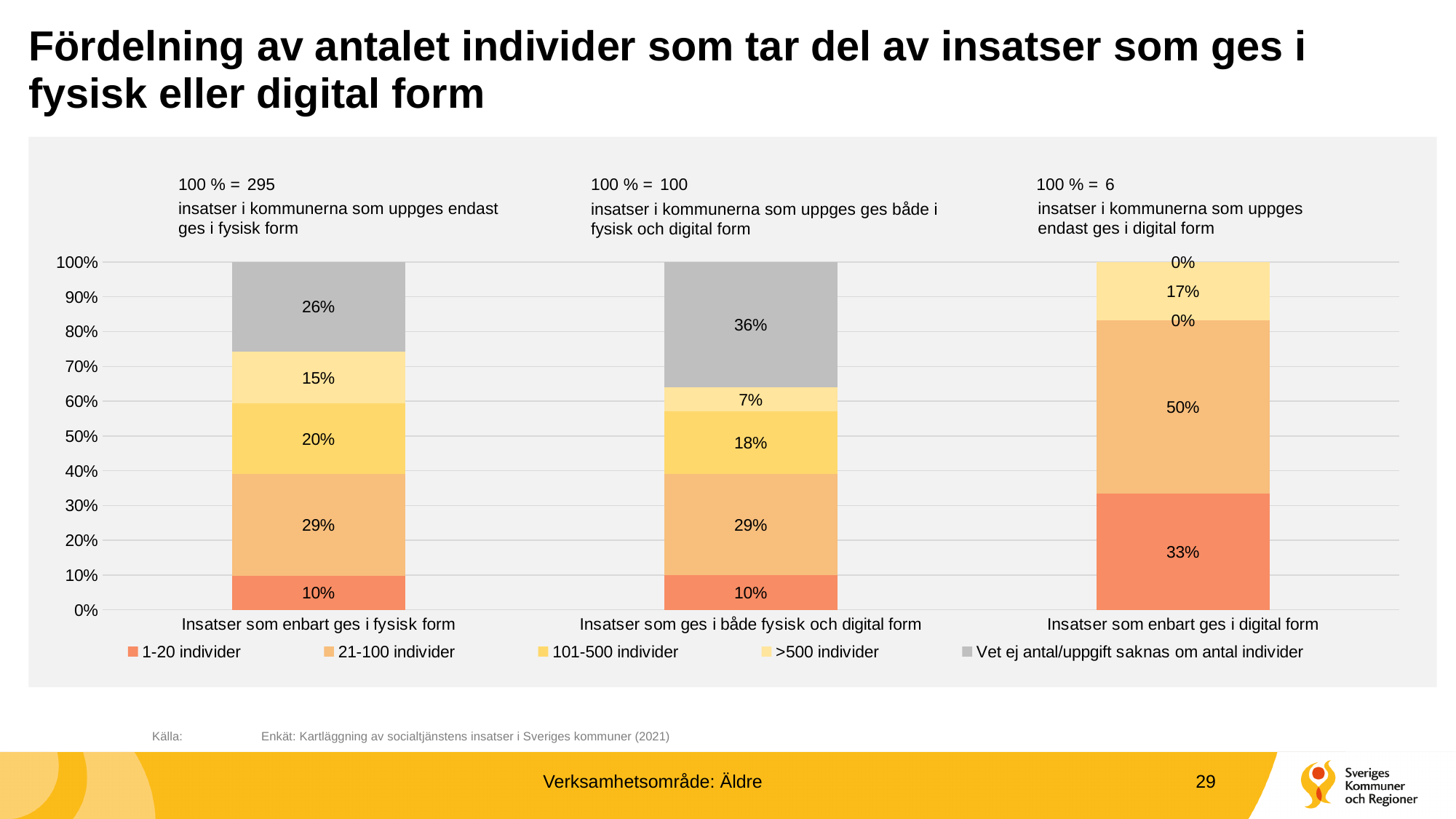
Which is larger: the '101-500 individer' value for 'Insatser som enbart ges i fysisk form' or for 'Insatser som ges i både fysisk och digital form'? Insatser som enbart ges i fysisk form What is the difference between the '>500 individer' values for 'Insatser som enbart ges i fysisk form' and 'Insatser som ges i både fysisk och digital form'? 8% How many series does the legend list? 5 Which category has the lowest value for '101-500 individer'? Insatser som enbart ges i digital form What is the value for '1-20 individer' in the category 'Insatser som enbart ges i digital form'? 33% What is the value for '>500 individer' in the category 'Insatser som enbart ges i fysisk form'? 15% What kind of chart is shown on the slide? Stacked bar chart Which category has the highest value for 'Vet ej antal/uppgift saknas om antal individer'? Insatser som ges i både fysisk och digital form What is the value for 'Vet ej antal/uppgift saknas om antal individer' in the category 'Insatser som ges i både fysisk och digital form'? 36% According to the note above the chart, how many insatser does 100 % correspond to for the category 'Insatser som enbart ges i fysisk form'? 295 What is the value for '21-100 individer' in the category 'Insatser som enbart ges i digital form'? 50% How many categories are shown on the x axis? 3